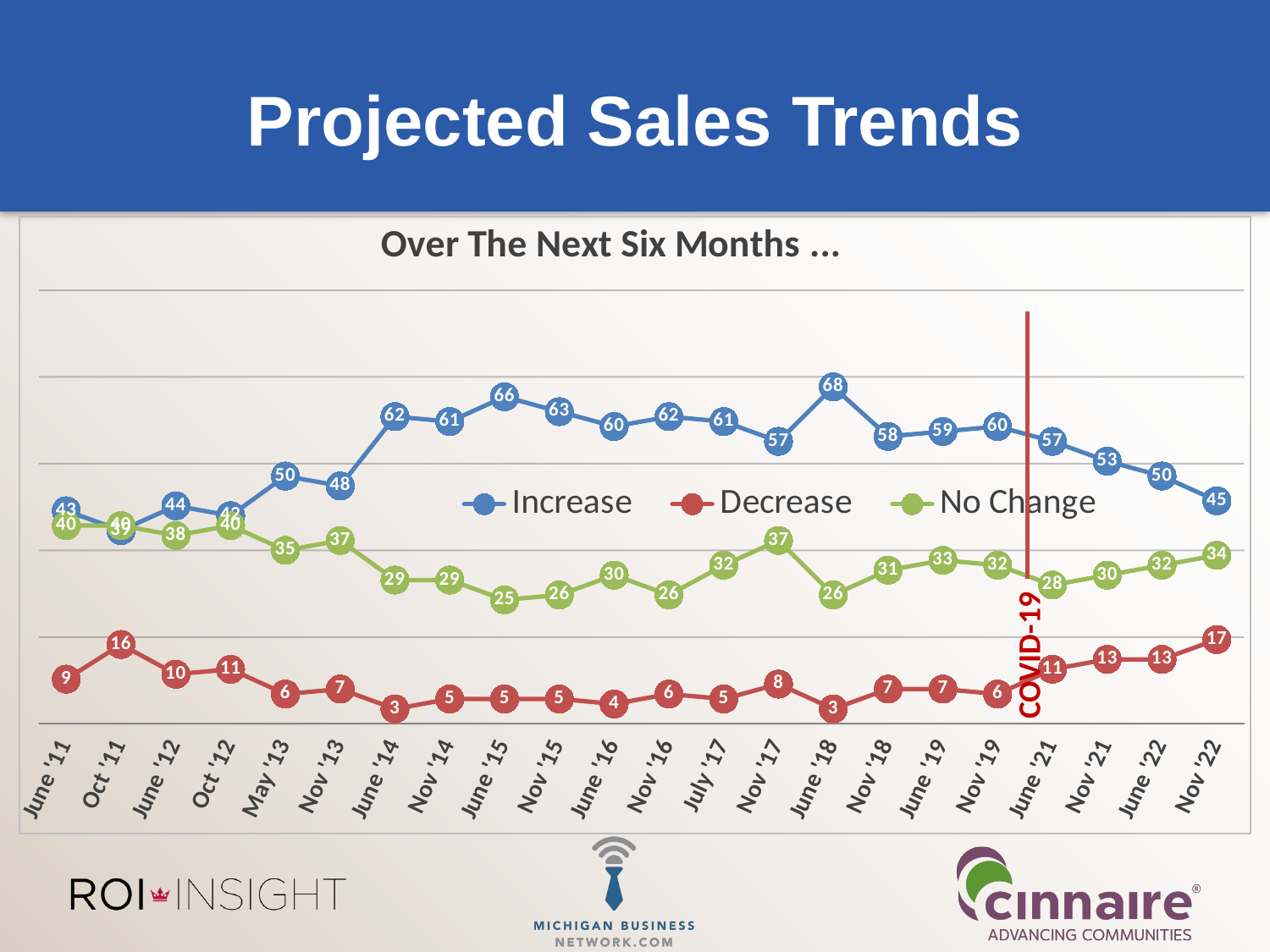
What is the value of the No Change series at June '15? 25 What is the value of the Decrease series at Nov '22? 17 How many series does the legend list? 3 What is the value of the Increase series at June '18? 68 What is the title of the chart? Over The Next Six Months ... From June '19 to Nov '22, does the Increase series rise or fall? Fall At which x-axis point does the Increase series reach its highest value? June '18 What kind of chart is shown on the slide? Line chart At which x-axis point does the No Change series reach its lowest value? June '15 How many x-axis points are plotted for each series? 22 What is the difference between the Increase value at June '18 and the Increase value at Nov '22? 23 Which is larger at Nov '17: the Increase value or the No Change value? Increase